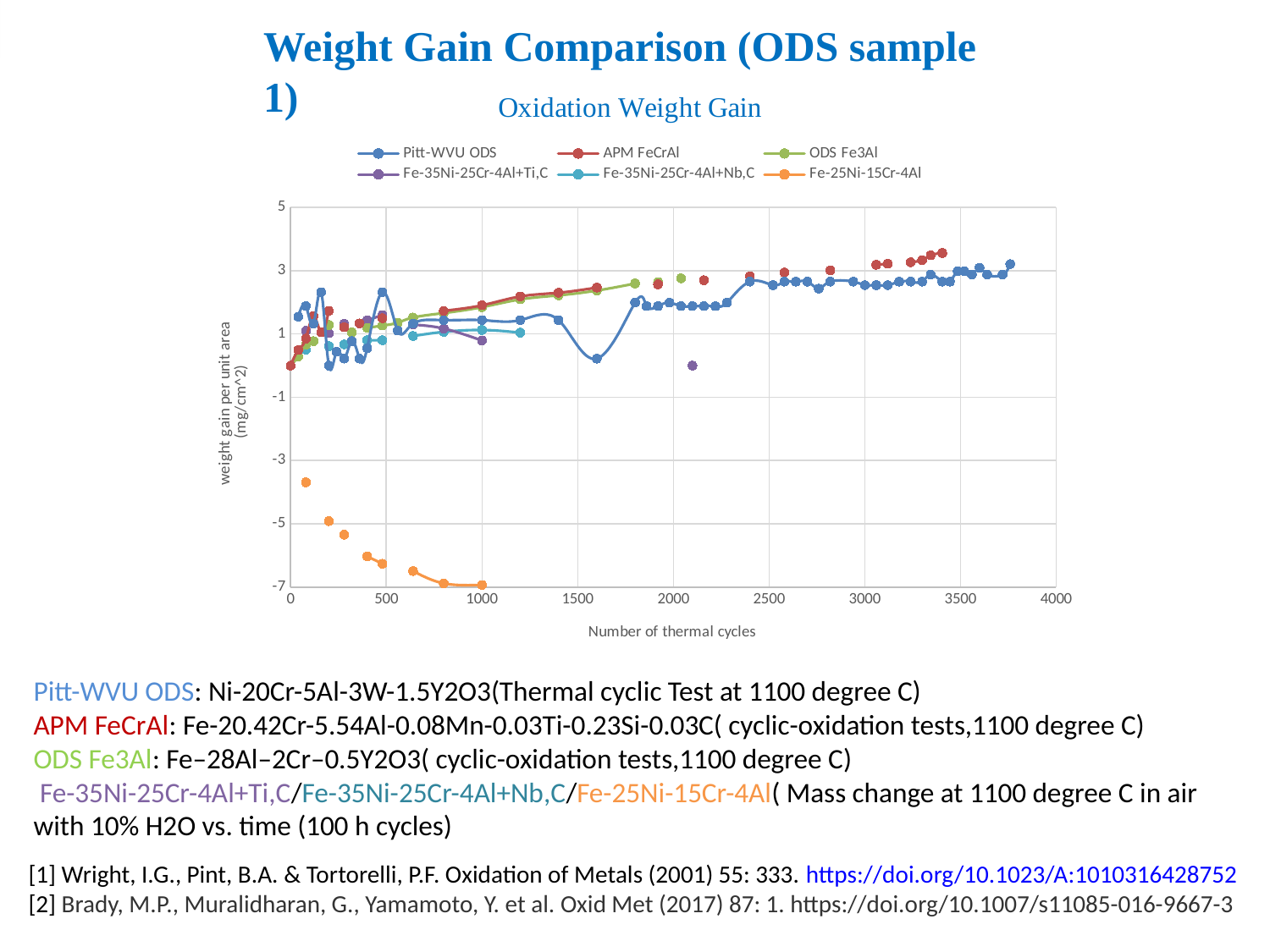
Which series extends to the largest number of thermal cycles on the chart? Pitt-WVU ODS Is the value for APM FeCrAl at about 3400 thermal cycles greater or less than 3? greater Which series has the lowest weight gain values on the chart? Fe-25Ni-15Cr-4Al What is the label of the x axis of the chart? Number of thermal cycles What is the title of the chart? Oxidation Weight Gain Which series reaches the highest weight gain value on the chart? APM FeCrAl How many series does the chart legend list? 6 Is the value for Fe-25Ni-15Cr-4Al at about 100 thermal cycles greater or less than -3? less Do the values for APM FeCrAl generally rise or fall as the number of thermal cycles increases? rise Is the value for Fe-25Ni-15Cr-4Al at 1000 thermal cycles greater or less than -5? less Do the values for Fe-25Ni-15Cr-4Al rise or fall as the number of thermal cycles increases? fall What kind of chart is shown on the slide? line chart